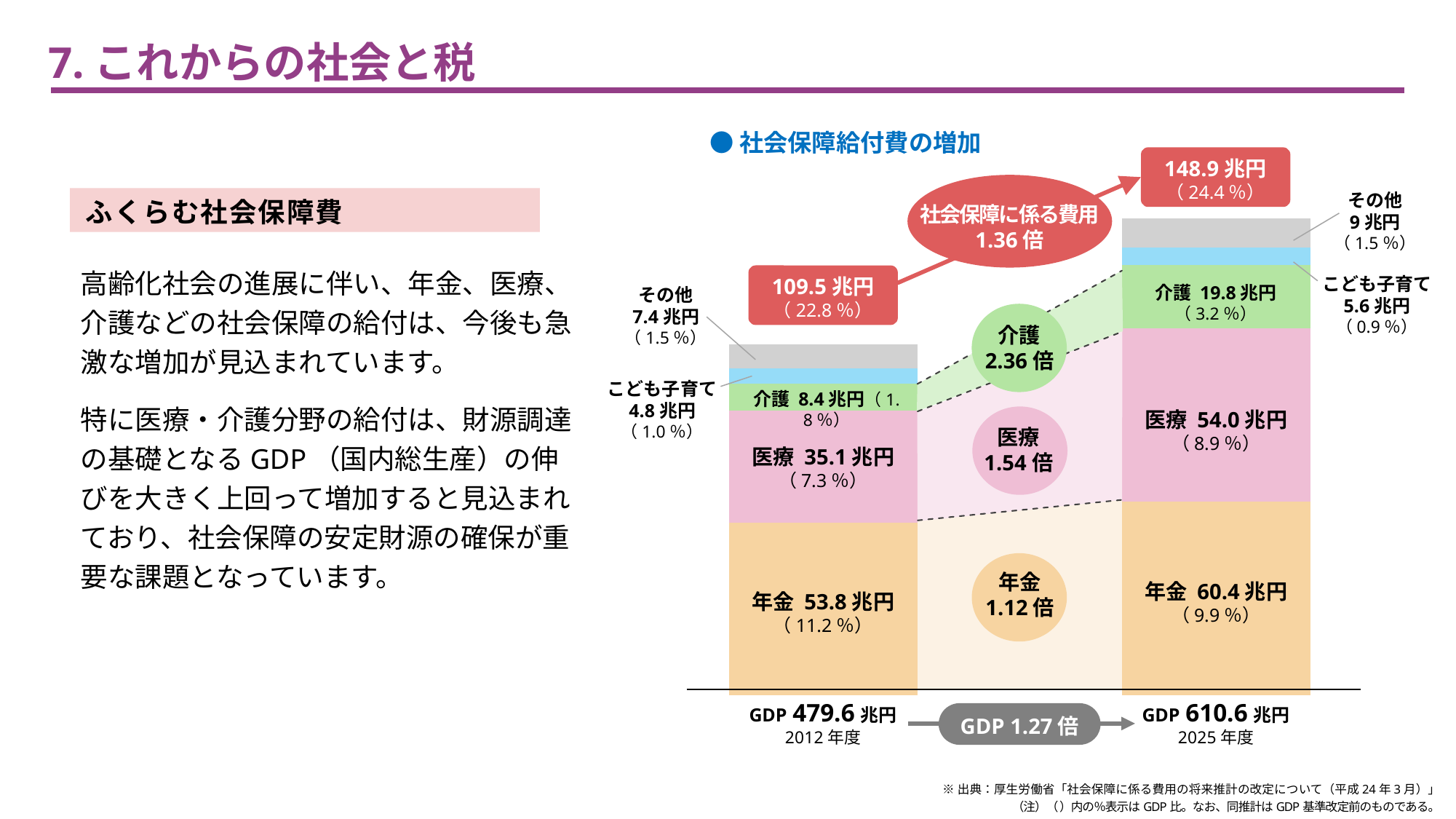
What is the value for 年金 in 2012年度? 53.8 兆円 What is the total social security benefit cost shown for 2025年度? 148.9 兆円 Does the value for 年金 rise or fall from 2012年度 to 2025年度? rise Which is larger: 医療 in 2025年度 or 年金 in 2012年度? 医療 in 2025年度 What is the total social security benefit cost shown for 2012年度? 109.5 兆円 Which category is the smallest in the 2012年度 bar? こども子育て What kind of chart is shown? stacked bar chart How many categories are stacked in each bar? 5 What is the value for 医療 in 2025年度? 54.0 兆円 Which category is the largest in the 2012年度 bar? 年金 What is the difference between 介護 in 2025年度 and 介護 in 2012年度? 11.4 兆円 By what factor does GDP grow from 2012年度 to 2025年度 according to the chart? 1.27 倍